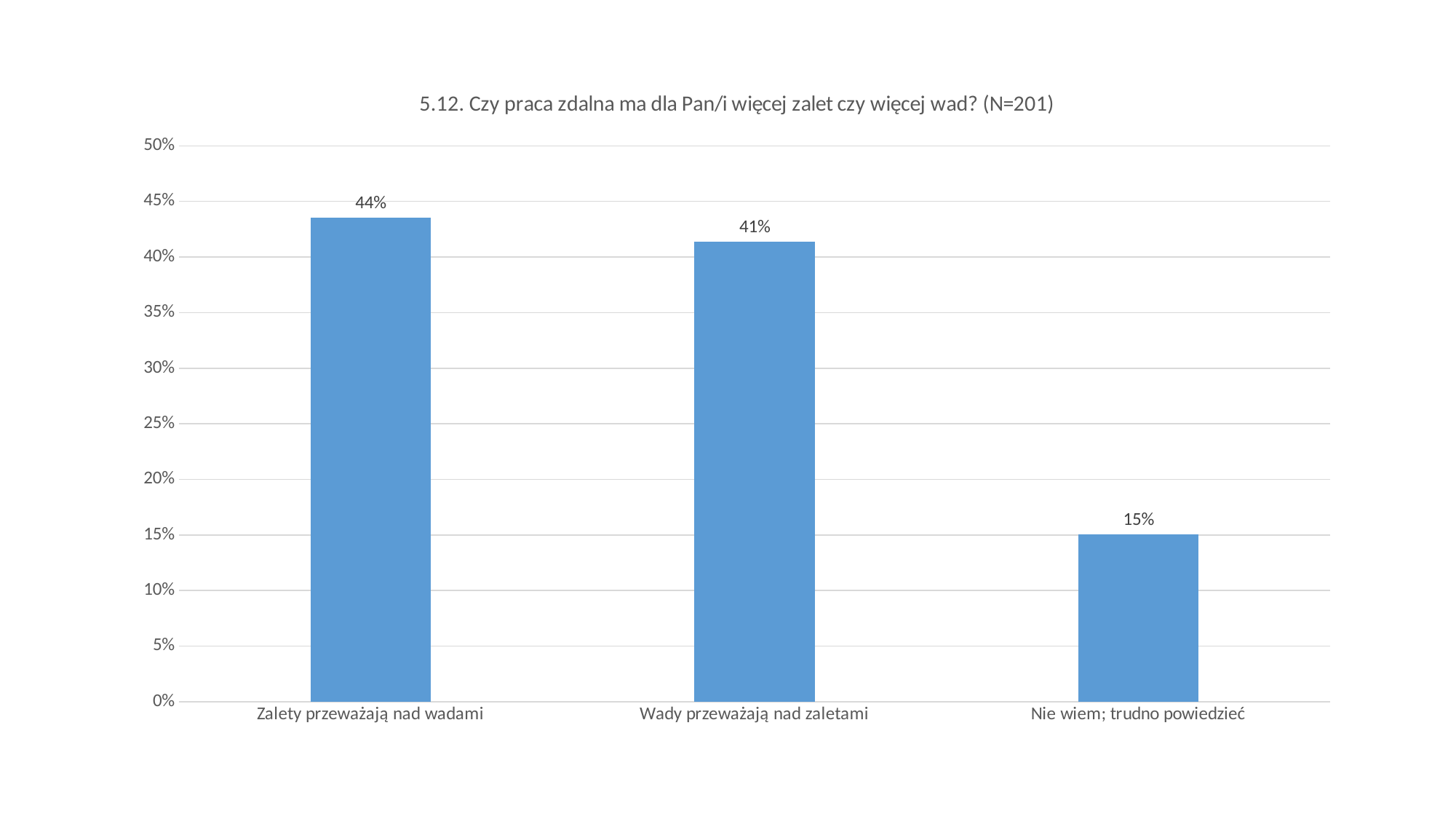
Which is larger: the value for "Wady przeważają nad zaletami" or the value for "Nie wiem; trudno powiedzieć"? Wady przeważają nad zaletami What is the title of the chart? 5.12. Czy praca zdalna ma dla Pan/i więcej zalet czy więcej wad? (N=201) How many categories are shown on the x axis? 3 What is the value for "Wady przeważają nad zaletami"? 41% Which category has the highest value? Zalety przeważają nad wadami What is the value for "Nie wiem; trudno powiedzieć"? 15% What is the difference between the values for "Zalety przeważają nad wadami" and "Nie wiem; trudno powiedzieć"? 29% What kind of chart is shown on the slide? bar chart Which category has the lowest value? Nie wiem; trudno powiedzieć What is the value for "Zalety przeważają nad wadami"? 44% Is the value for "Nie wiem; trudno powiedzieć" greater or less than 20%? less What is the difference between the values for "Wady przeważają nad zaletami" and "Nie wiem; trudno powiedzieć"? 26%